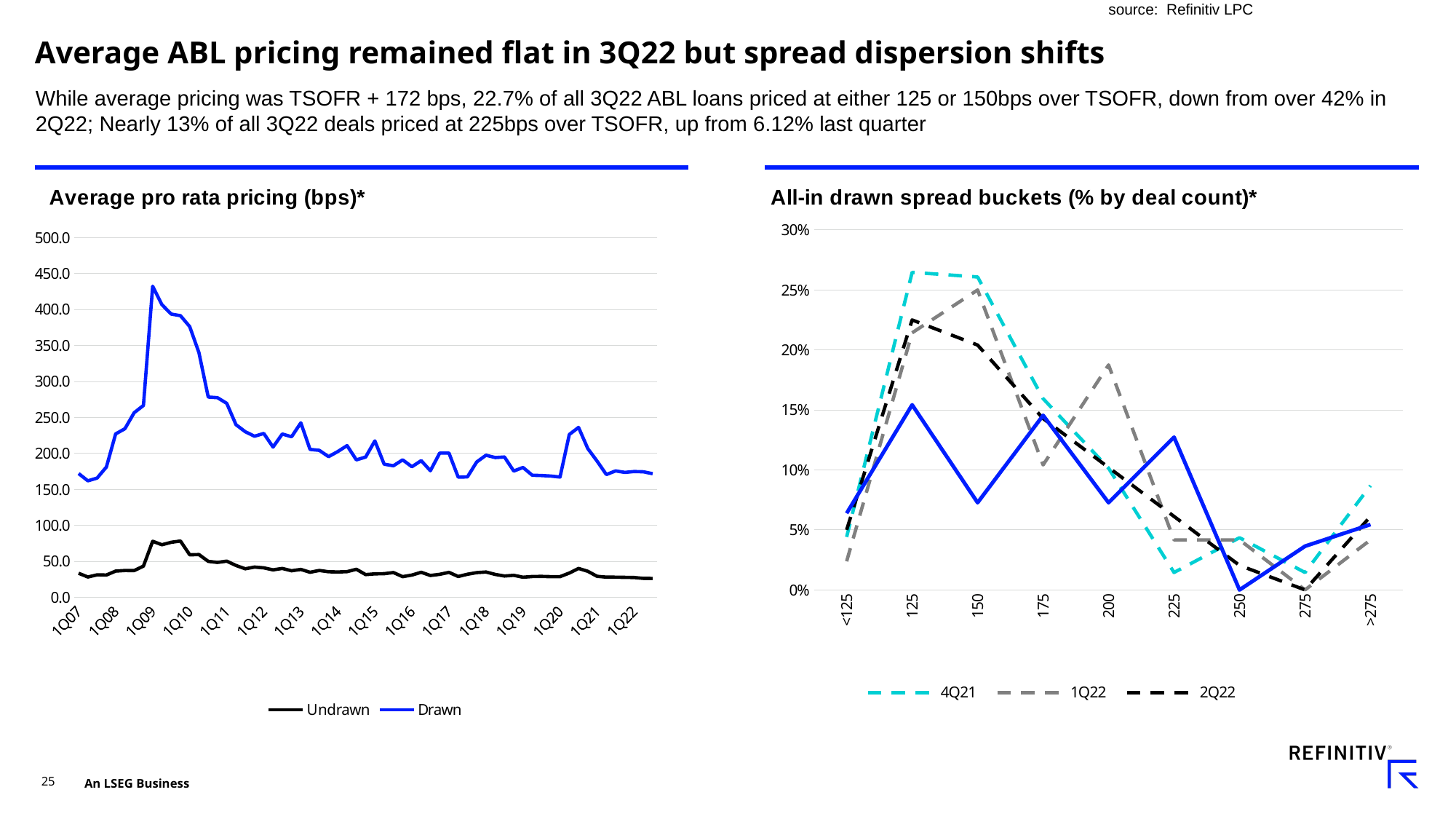
In the 'Average pro rata pricing (bps)*' chart, which series is higher at 1Q22, Undrawn or Drawn? Drawn In the 'Average pro rata pricing (bps)*' chart, is the Undrawn value at 1Q07 greater or less than 50.0? less How many series does the legend of the 'Average pro rata pricing (bps)*' chart list? 2 In the 'All-in drawn spread buckets (% by deal count)*' chart, which bucket has the highest 1Q22 value? 150 What kind of chart is the 'All-in drawn spread buckets (% by deal count)*' chart? line chart How many spread buckets are shown on the x axis of the 'All-in drawn spread buckets (% by deal count)*' chart? 9 What kind of chart is the 'Average pro rata pricing (bps)*' chart? line chart How many series does the legend of the 'All-in drawn spread buckets (% by deal count)*' chart list? 3 In the 'Average pro rata pricing (bps)*' chart, does the Drawn line rise or fall between 1Q09 and 1Q12? fall In the 'All-in drawn spread buckets (% by deal count)*' chart, is the 4Q21 value for the 125 bucket greater or less than 25%? greater In the 'Average pro rata pricing (bps)*' chart, is the peak of the Drawn line around 1Q09 greater or less than 400.0? greater What are the two series named in the legend of the 'Average pro rata pricing (bps)*' chart? Undrawn and Drawn